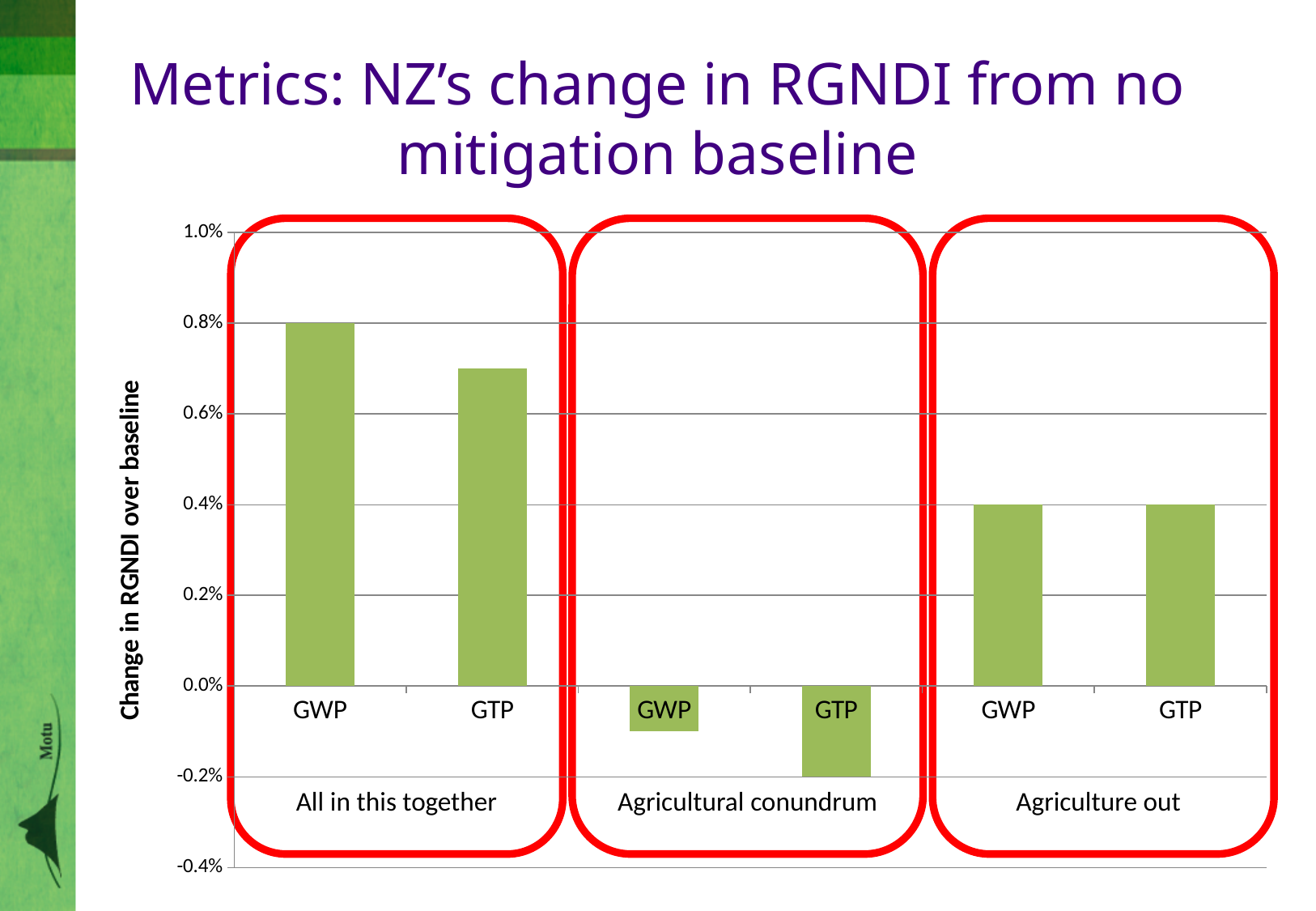
What is the change in RGNDI for GWP under the 'Agriculture out' scenario? 0.4% How many bars are plotted in the chart? 6 Which bar shows the lowest change in RGNDI over baseline? GTP, Agricultural conundrum What kind of chart is shown on the slide? bar chart Is the value for GWP under 'Agricultural conundrum' greater or less than 0.0%? less What is the change in RGNDI for GWP under the 'All in this together' scenario? 0.8% Is the value for GTP under 'All in this together' greater or less than 0.6%? greater Which bar shows the highest change in RGNDI over baseline? GWP, All in this together What is the change in RGNDI for GTP under the 'Agricultural conundrum' scenario? -0.2% Under 'All in this together', which is larger: the GWP bar or the GTP bar? GWP What is the label on the vertical axis of the chart? Change in RGNDI over baseline What is the difference between the GWP value under 'All in this together' and the GWP value under 'Agriculture out'? 0.4%